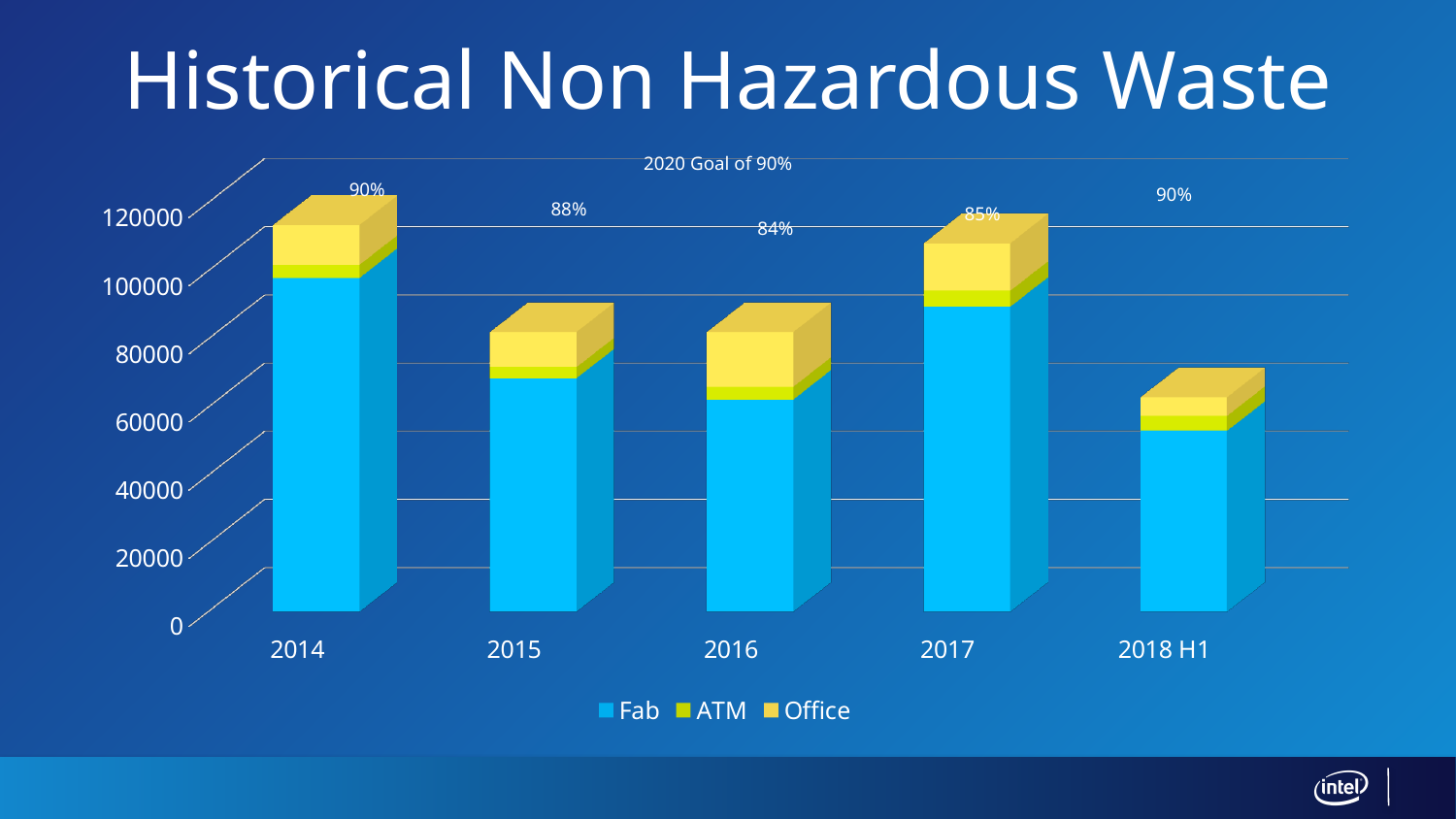
What type of chart is shown on the slide? Stacked bar chart How many categories are shown on the x axis? 5 Which category has the lowest total stacked bar? 2018 H1 How many series does the legend list? 3 What is the 2020 goal stated on the chart? 90% What percentage label is shown above the 2017 bar? 85% Which year has the highest total stacked bar? 2014 What percentage label is shown above the 2016 bar? 84% What is the title of the chart? Historical Non Hazardous Waste Is the total value for 2018 H1 greater or less than 80000? less What percentage label is shown above the 2014 bar? 90% Is the total value for 2017 greater or less than 100000? greater